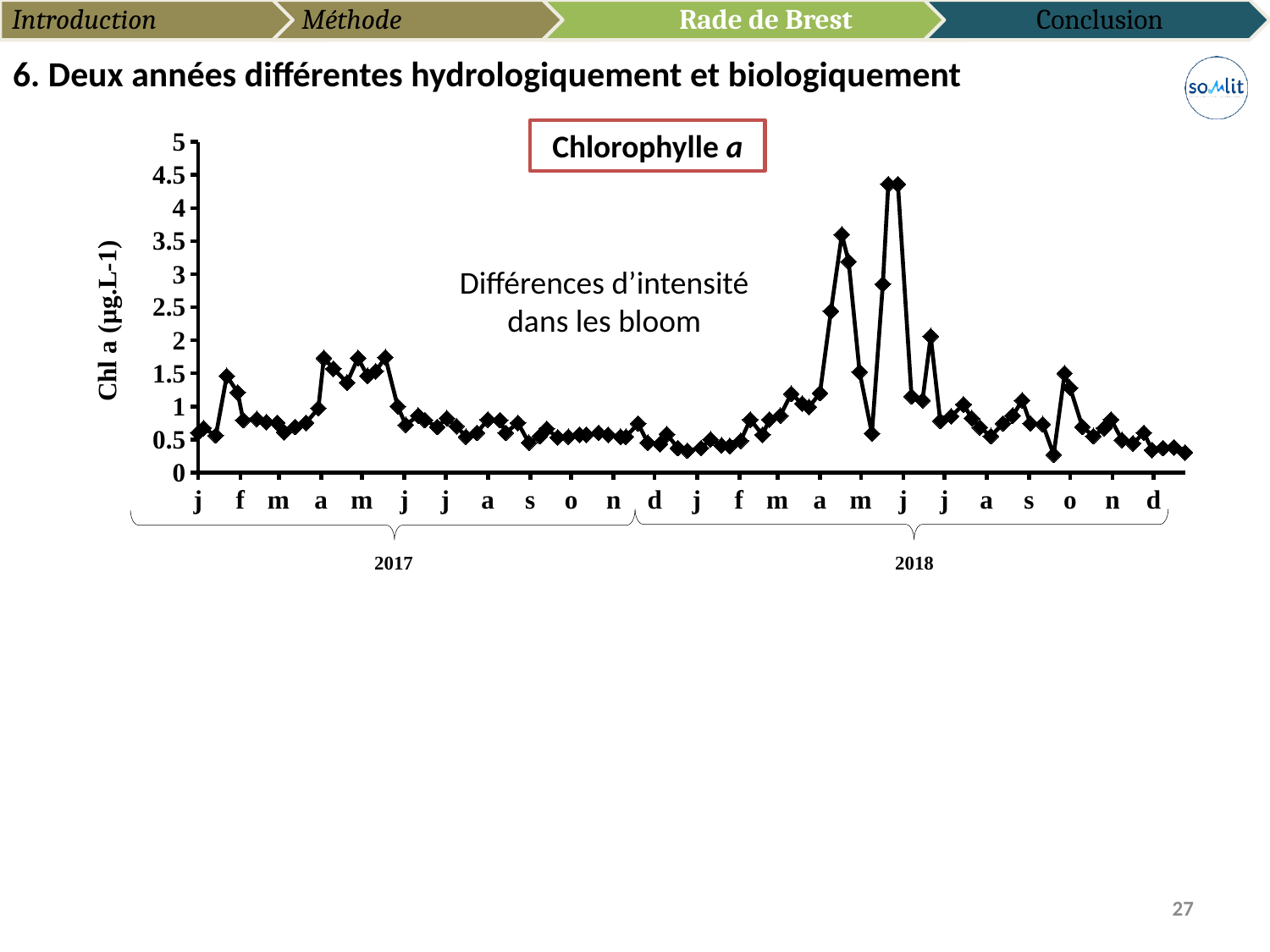
Is the chlorophyll a value at the start of January 2017 greater or less than 1? less Is the highest chlorophyll a value in 2017 greater or less than 2? less Is the highest chlorophyll a value in 2018 greater or less than 4? greater Does the chlorophyll a value rise or fall from the June 2018 peak to December 2018? fall What is the title shown in the box above the chart? Chlorophylle a Which two years does the x axis cover? 2017 and 2018 What is the highest tick value shown on the y axis? 5 What is the label of the y axis? Chl a (µg.L-1) Which year has the larger peak in chlorophyll a, 2017 or 2018? 2018 In which year does the chlorophyll a series reach its highest value? 2018 What kind of chart is shown on the slide? line chart